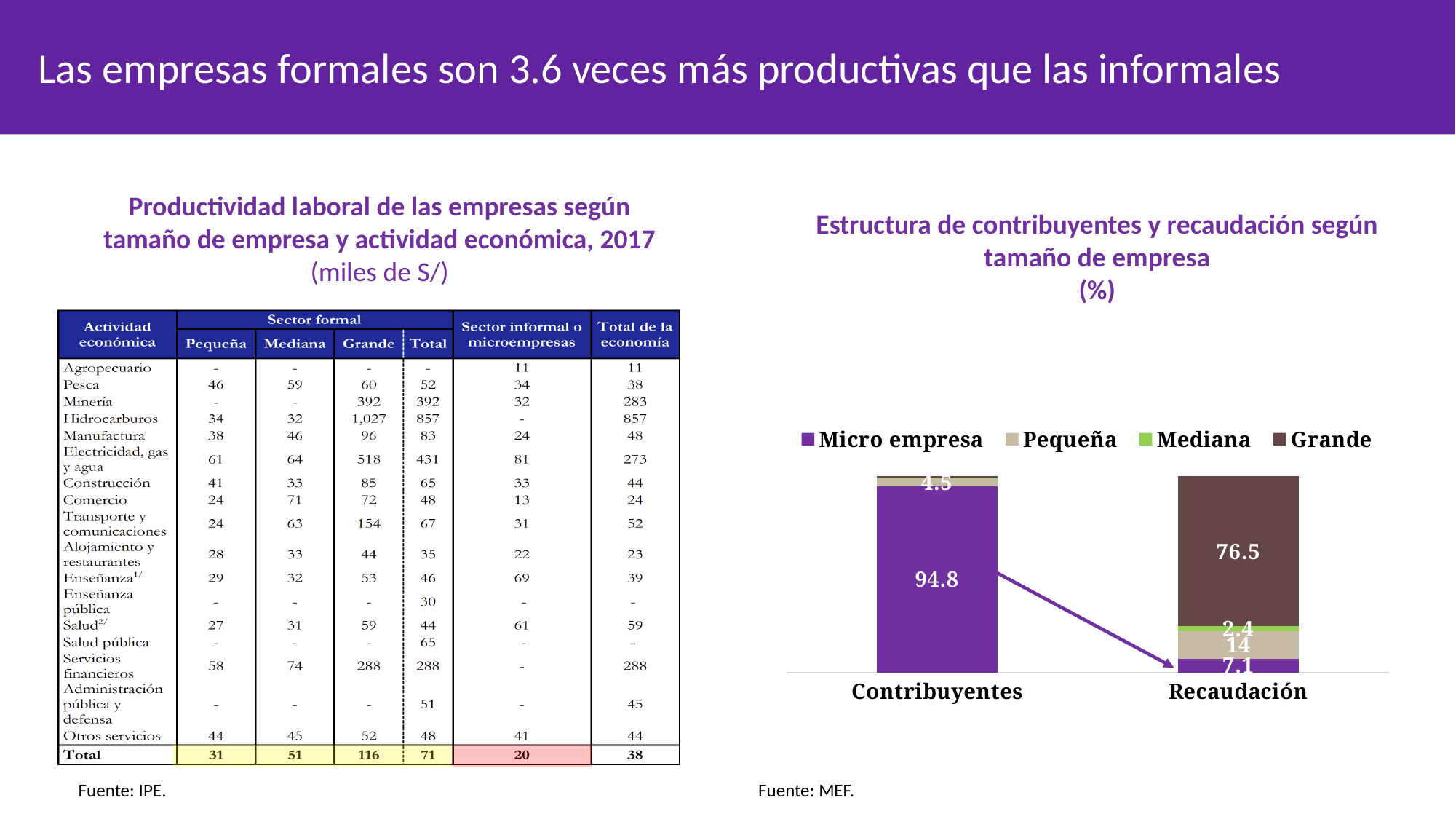
In the chart 'Estructura de contribuyentes y recaudación según tamaño de empresa', which series has the smallest labelled share of the Recaudación bar? Mediana In the chart 'Estructura de contribuyentes y recaudación según tamaño de empresa', what is the difference between the Micro empresa value for Contribuyentes and the Micro empresa value for Recaudación? 87.7 In the chart 'Estructura de contribuyentes y recaudación según tamaño de empresa', what is the value for Pequeña in the Contribuyentes bar? 4.5 In the chart 'Estructura de contribuyentes y recaudación según tamaño de empresa', how many series does the legend list? 4 In the chart 'Estructura de contribuyentes y recaudación según tamaño de empresa', which series has the largest share of the Recaudación bar? Grande In the chart 'Estructura de contribuyentes y recaudación según tamaño de empresa', what is the value for Micro empresa in the Recaudación bar? 7.1 In the chart 'Estructura de contribuyentes y recaudación según tamaño de empresa', what is the value for Mediana in the Recaudación bar? 2.4 In the chart 'Estructura de contribuyentes y recaudación según tamaño de empresa', what is the value for Pequeña in the Recaudación bar? 14 In the chart 'Estructura de contribuyentes y recaudación según tamaño de empresa', how many bars (categories) are shown on the x axis? 2 In the chart 'Estructura de contribuyentes y recaudación según tamaño de empresa', what is the value for Grande in the Recaudación bar? 76.5 In the chart 'Estructura de contribuyentes y recaudación según tamaño de empresa', what is the value for Micro empresa in the Contribuyentes bar? 94.8 What kind of chart is shown on the right side of the slide? stacked bar chart